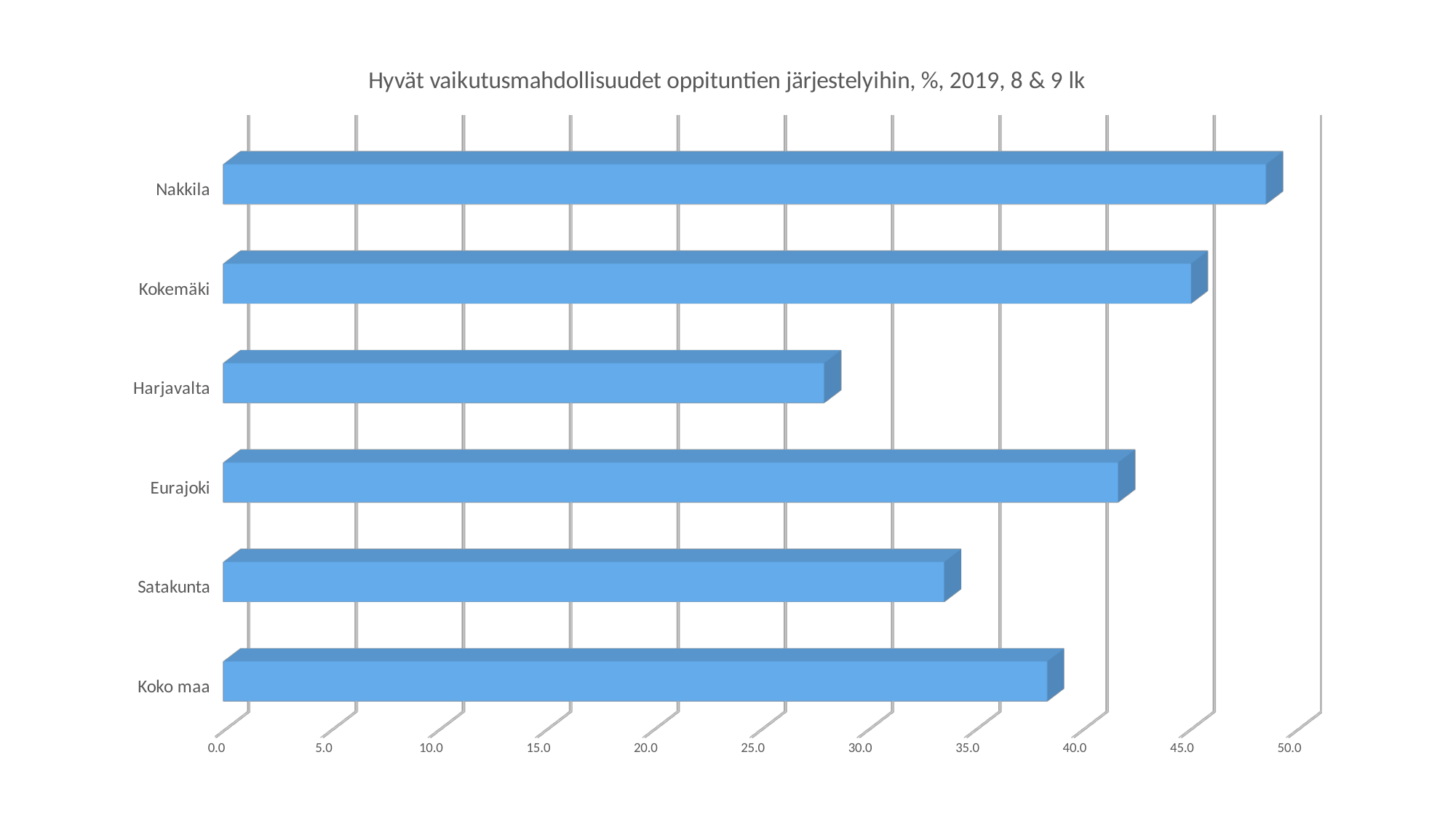
Is the value for Satakunta greater or less than 30? greater Which has a larger value, Kokemäki or Eurajoki? Kokemäki What is the title of the chart? Hyvät vaikutusmahdollisuudet oppituntien järjestelyihin, %, 2019, 8 & 9 lk How many categories are shown in the chart? 6 Which category has the highest value? Nakkila What kind of chart is shown on the slide? bar chart Which has a larger value, Satakunta or Koko maa? Koko maa Is the value for Kokemäki greater or less than 40? greater Is the value for Harjavalta greater or less than 30? less Which category has the lowest value? Harjavalta